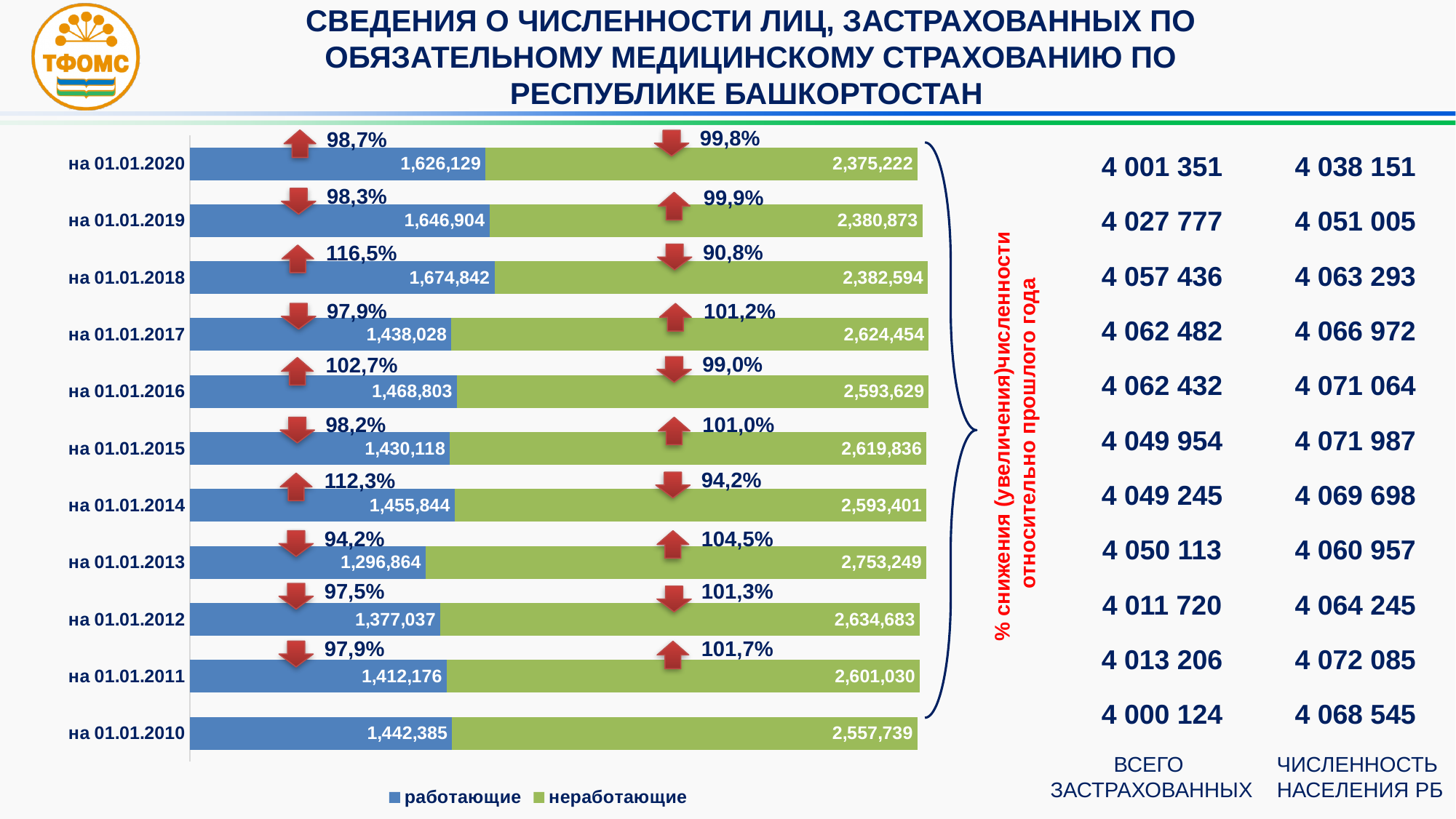
Which date has the larger неработающие value, 01.01.2017 or 01.01.2016? на 01.01.2017 What is the difference between the работающие values on 01.01.2019 and 01.01.2020? 20,775 What is the value for неработающие on 01.01.2013? 2,753,249 How many series does the legend list? 2 On which date is the value for работающие the lowest? на 01.01.2013 On which date is the value for неработающие the lowest? на 01.01.2020 What kind of chart is shown on the slide? Stacked bar chart What is the total of the stacked bar for 01.01.2010? 4 000 124 On which date is the value for неработающие the highest? на 01.01.2013 On which date is the value for работающие the highest? на 01.01.2018 What is the value for работающие on 01.01.2020? 1,626,129 How many dates (categories) are shown on the chart? 11